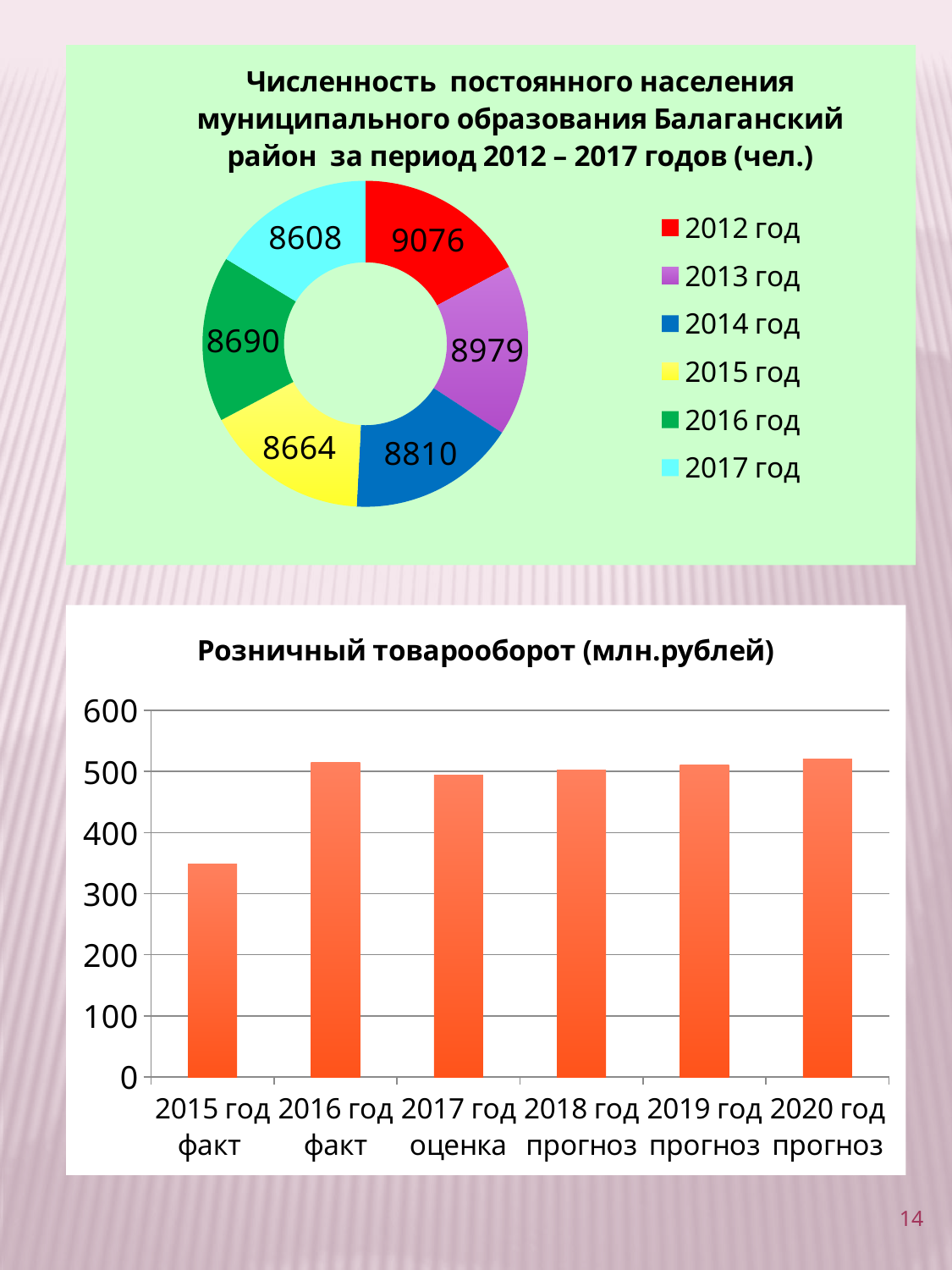
In the 'Розничный товарооборот (млн.рублей)' chart, how many bars are there? 6 In the population chart (top), what is the value for 2015 год? 8664 In the 'Розничный товарооборот (млн.рублей)' chart, is the value for 2020 год прогноз greater or less than 500? greater In the population chart (top), how many entries does the legend list? 6 In the population chart (top), which is larger, the value for 2016 год or 2015 год? 2016 год In the population chart (top), what is the difference between the values for 2012 год and 2017 год? 468 In the 'Розничный товарооборот (млн.рублей)' chart, is the value for 2015 год факт greater or less than 400? less In the population chart (top), what is the value for 2012 год? 9076 In the 'Розничный товарооборот (млн.рублей)' chart, which category has the lowest bar? 2015 год факт What kind of chart is the top chart on the slide? Doughnut (pie) chart In the population chart (top), which year has the lowest value? 2017 год In the population chart (top), which year has the highest value? 2012 год